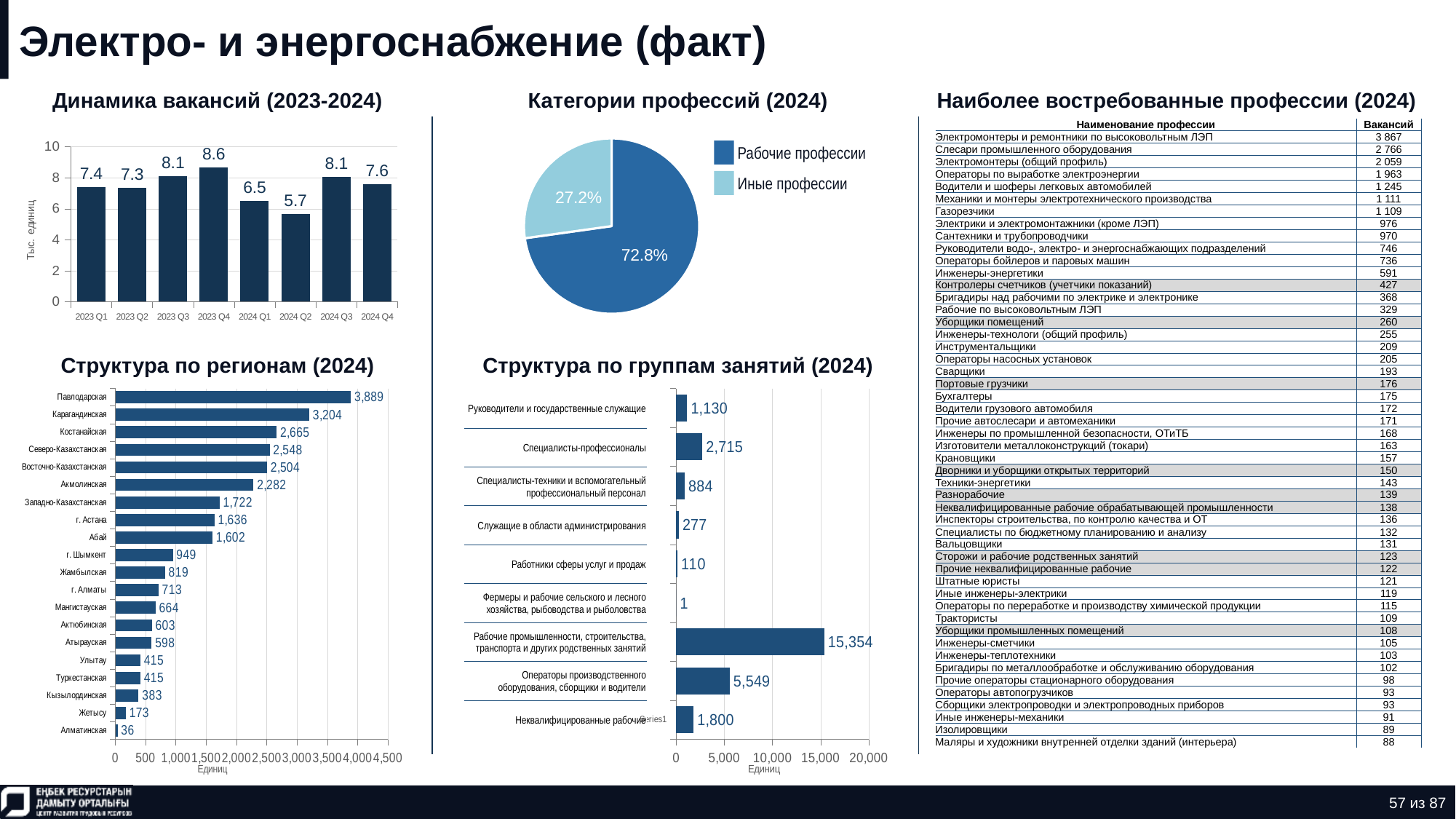
What type of chart is 'Структура по группам занятий (2024)'? Bar chart In the chart 'Структура по регионам (2024)', what is the difference between Павлодарская and Алматинская? 3,853 In the chart 'Структура по регионам (2024)', which region has the highest value? Павлодарская In the chart 'Динамика вакансий (2023-2024)', which quarter has the lowest value? 2024 Q2 In the chart 'Динамика вакансий (2023-2024)', how many quarters are plotted? 8 In the chart 'Динамика вакансий (2023-2024)', what is the value for 2023 Q4? 8.6 In the chart 'Структура по регионам (2024)', what is the value for Карагандинская? 3,204 In the pie chart 'Категории профессий (2024)', how many categories does the legend list? 2 In the chart 'Динамика вакансий (2023-2024)', what is the difference between the values for 2023 Q4 and 2024 Q2? 2.9 In the pie chart 'Категории профессий (2024)', what share do 'Рабочие профессии' have? 72.8% In the chart 'Структура по регионам (2024)', which is larger: г. Шымкент or г. Алматы? г. Шымкент In the chart 'Структура по группам занятий (2024)', what is the value for 'Операторы производственного оборудования, сборщики и водители'? 5,549